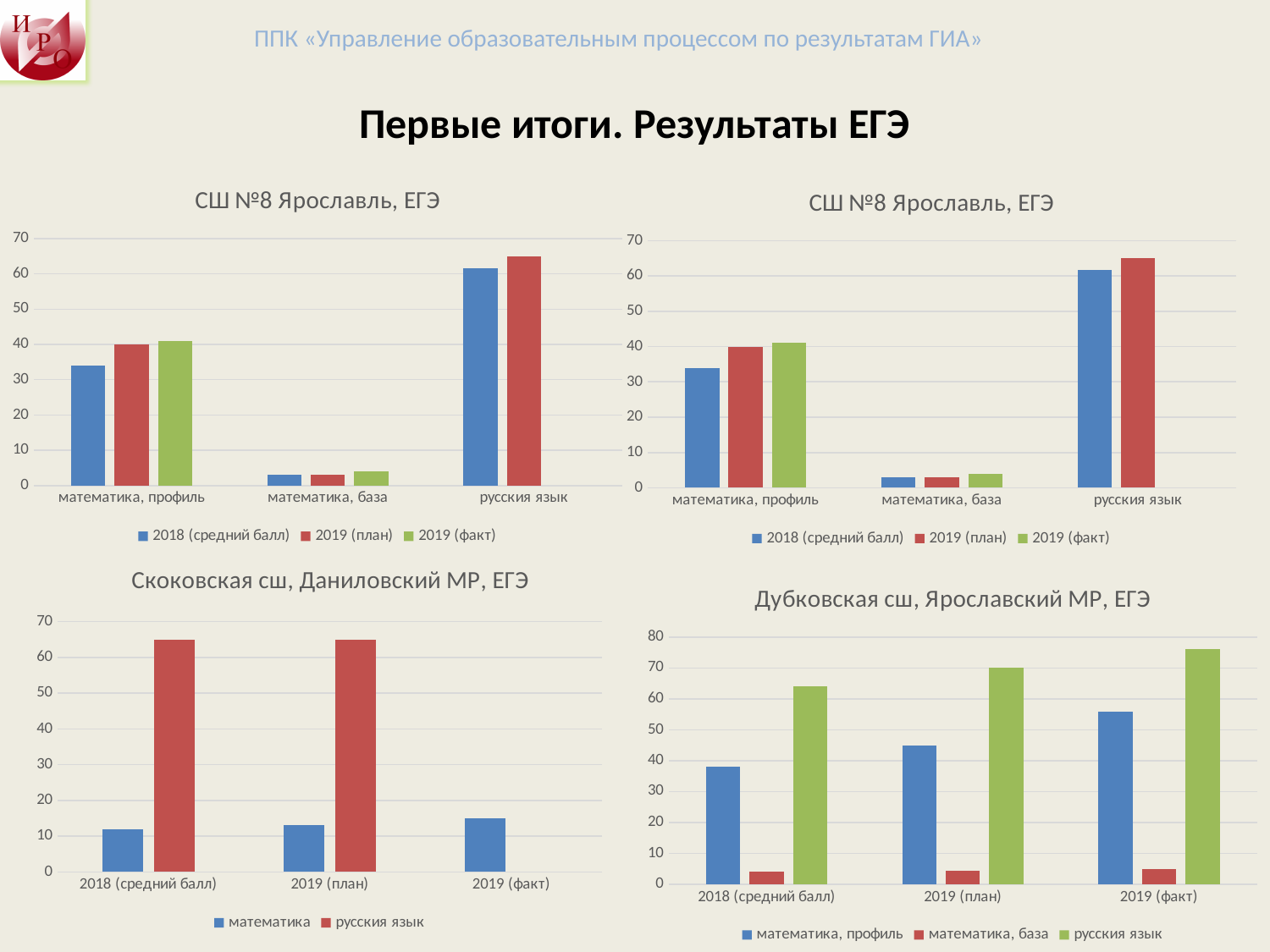
In the top-left chart "СШ №8 Ярославль, ЕГЭ", which category has the lowest 2019 (план) value? математика, база What is the title of the bottom-left chart on the slide? Скоковская сш, Даниловский МР, ЕГЭ What type of chart is the bottom-right chart titled "Дубковская сш, Ярославский МР, ЕГЭ"? bar chart In the bottom-left chart "Скоковская сш, Даниловский МР, ЕГЭ", how many categories are shown on the x axis? 3 In the bottom-left chart "Скоковская сш, Даниловский МР, ЕГЭ", is the математика value for 2019 (факт) greater or less than 20? less In the bottom-right chart "Дубковская сш, Ярославский МР, ЕГЭ", is the математика, профиль value for 2019 (факт) greater or less than 50? greater In the bottom-left chart "Скоковская сш, Даниловский МР, ЕГЭ", which is larger for 2018 (средний балл): математика or русския язык? русския язык In the top-left chart "СШ №8 Ярославль, ЕГЭ", how many series does the legend list? 3 In the bottom-right chart "Дубковская сш, Ярославский МР, ЕГЭ", do the русския язык values rise or fall from 2018 (средний балл) to 2019 (факт)? rise In the top-left chart "СШ №8 Ярославль, ЕГЭ", which category has the highest 2018 (средний балл) value? русския язык In the top-left chart "СШ №8 Ярославль, ЕГЭ", is the 2019 (план) value for русския язык greater or less than 60? greater